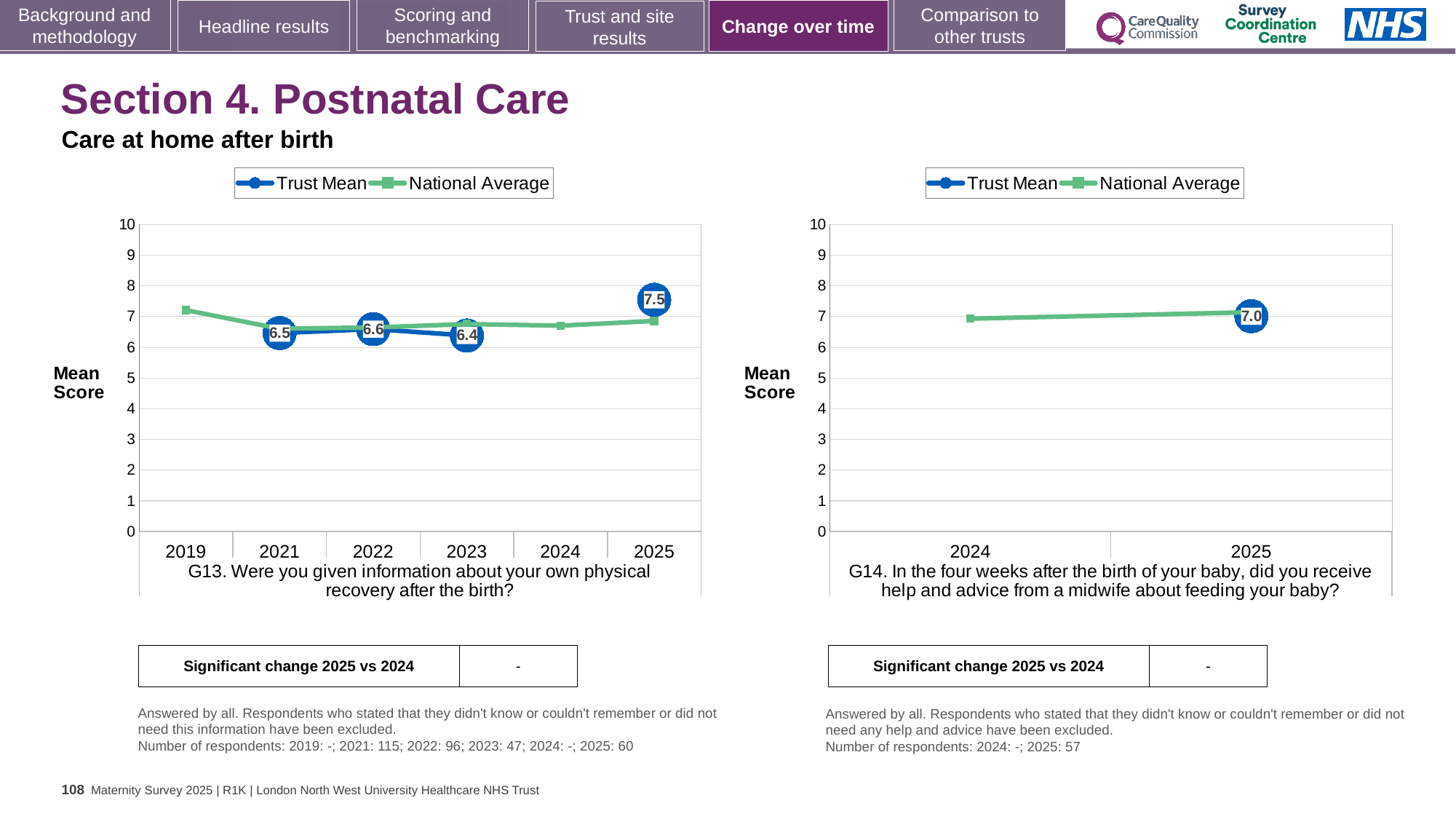
In the G14 chart on the right, what is the Trust Mean for 2025? 7.0 How many years are shown on the x axis of the G13 chart on the left? 6 In the G13 chart on the left, what is the Trust Mean for 2021? 6.5 In the G13 chart on the left, is the National Average for 2019 greater or less than 7? greater How many series does the legend of the G14 chart on the right list? 2 What type of chart is the G14 chart on the right? Line chart In the G13 chart on the left, what is the difference between the Trust Mean for 2025 and the Trust Mean for 2023? 1.1 In the G13 chart on the left, which year has the lowest labelled Trust Mean? 2023 In the G13 chart on the left, which year has the highest labelled Trust Mean? 2025 In the G13 chart on the left, is the Trust Mean higher in 2022 or in 2025? 2025 In the G13 chart on the left, what is the Trust Mean for 2025? 7.5 In the G13 chart on the left, what is the Trust Mean for 2023? 6.4